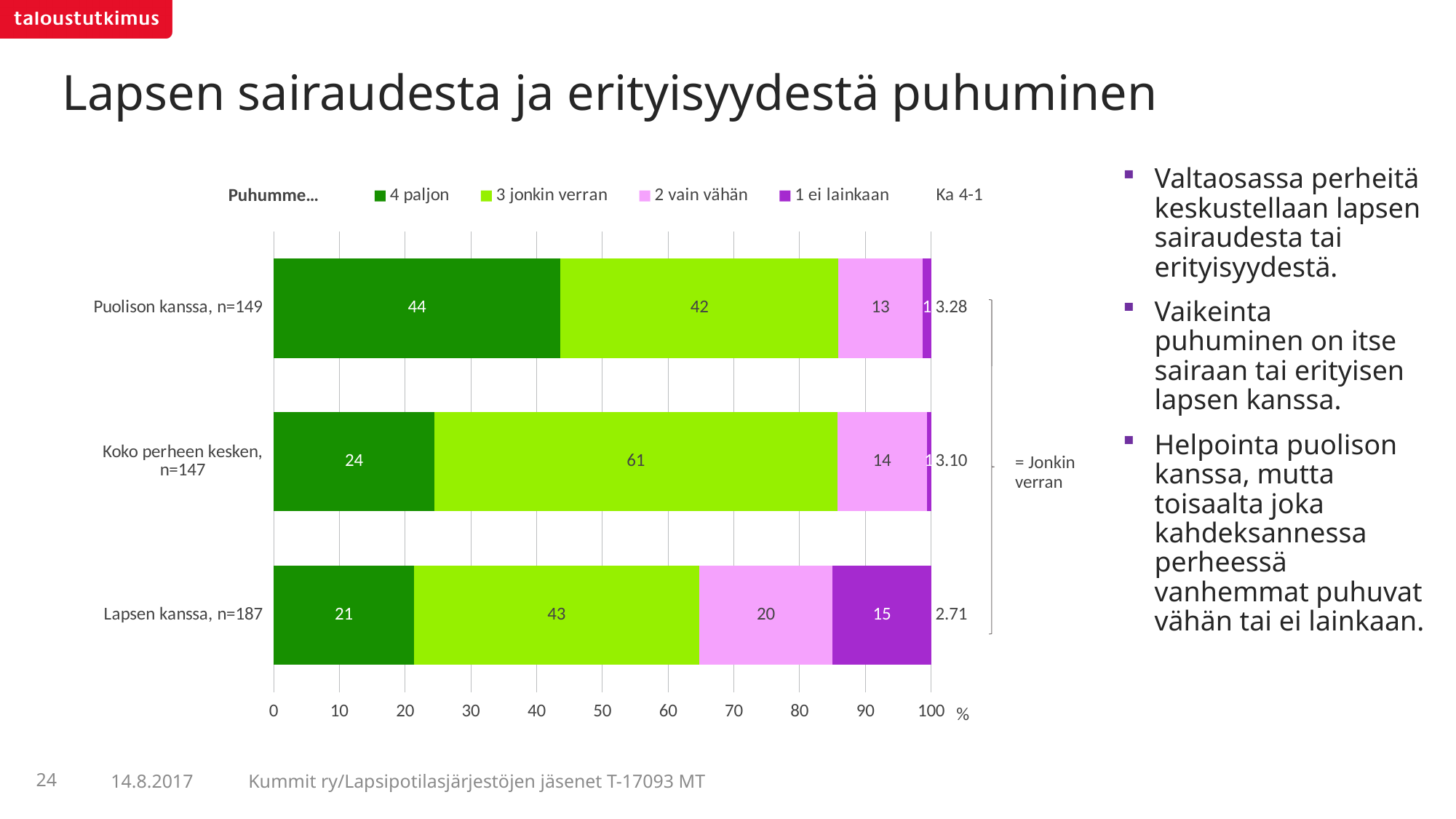
Which category has the lowest mean (Ka) value? Lapsen kanssa, n=187 What is the mean (Ka) value shown for "Lapsen kanssa, n=187"? 2.71 What is the value of "1 ei lainkaan" for "Lapsen kanssa, n=187"? 15 Which legend entry is shown in dark green? 4 paljon What is the value of "4 paljon" for "Puolison kanssa, n=149"? 44 What is the difference between the "3 jonkin verran" values for "Koko perheen kesken, n=147" and "Lapsen kanssa, n=187"? 18 How many series does the legend list for the chart? 5 What kind of chart is shown on the slide? stacked bar chart How many categories are plotted in the chart? 3 What is the value of "3 jonkin verran" for "Koko perheen kesken, n=147"? 61 Which category has the highest value for "4 paljon"? Puolison kanssa, n=149 Which is larger: the "2 vain vähän" value for "Lapsen kanssa, n=187" or for "Puolison kanssa, n=149"? Lapsen kanssa, n=187